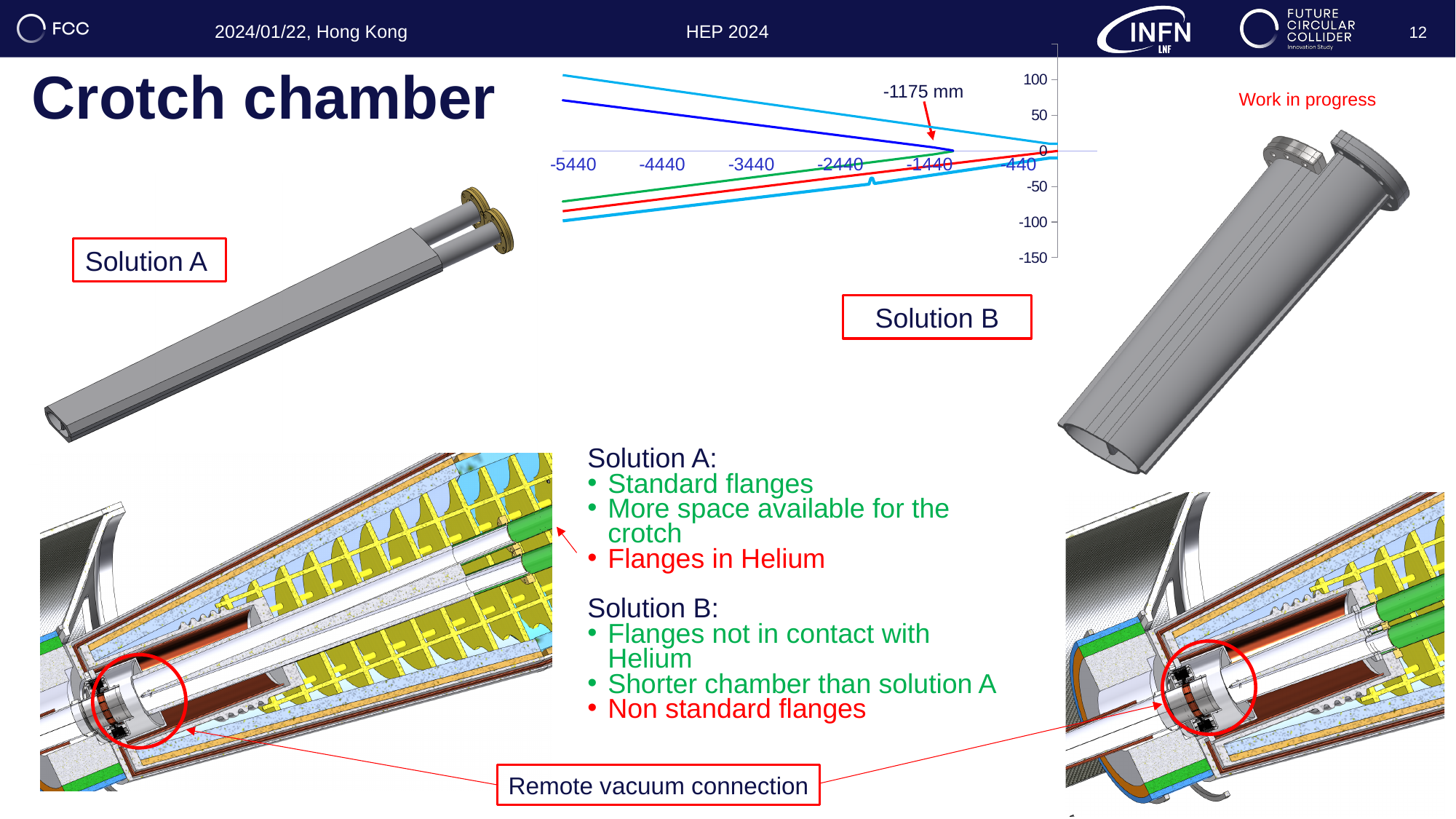
What value is annotated with the arrow on the chart at the top of the slide? -1175 mm On the chart at the top of the slide, does the dark blue line rise or fall as x increases from -5440 toward 0? fall What is the leftmost tick label on the x axis of the chart at the top of the slide? -5440 How many tick labels are shown on the x axis of the chart at the top of the slide? 6 On the chart at the top of the slide, is the value of the dark blue line at x = -5440 greater or less than 50? greater On the chart at the top of the slide, is the value of the upper light blue line at x = -3440 greater or less than 0? greater What kind of chart is shown at the top centre of the slide? line chart On the chart at the top of the slide, does the lower light blue line rise or fall as x increases from -5440 toward 0? rise On the chart at the top of the slide, is the value of the green line at x = -5440 greater or less than -50? less What is the lowest tick label on the y axis of the chart at the top of the slide? -150 On the chart at the top of the slide, at x = -5440, which line is higher: the dark blue line or the red line? the dark blue line